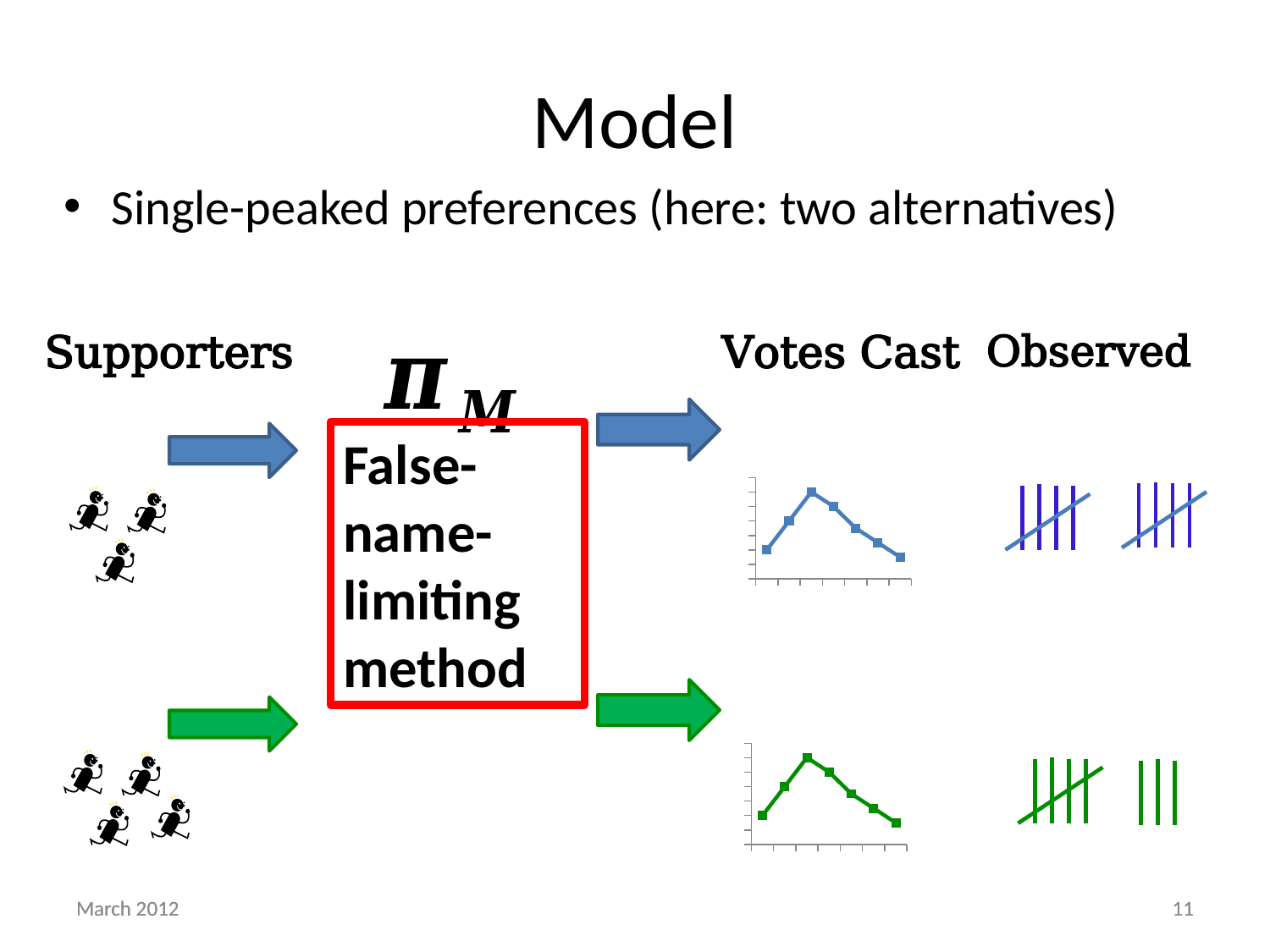
How many data points are plotted in the lower (green) line chart? 7 What colour is the line in the lower chart under "Votes Cast"? green What kind of chart is the upper chart under "Votes Cast"? line chart What kind of chart is the lower chart under "Votes Cast"? line chart In the upper (blue) line chart, do the values rise or fall after the peak as you move right along the x axis? fall How many line charts are shown on the slide? 2 In the lower (green) line chart, do the values rise or fall from the first point to the peak? rise How many data points are plotted in the upper (blue) line chart? 7